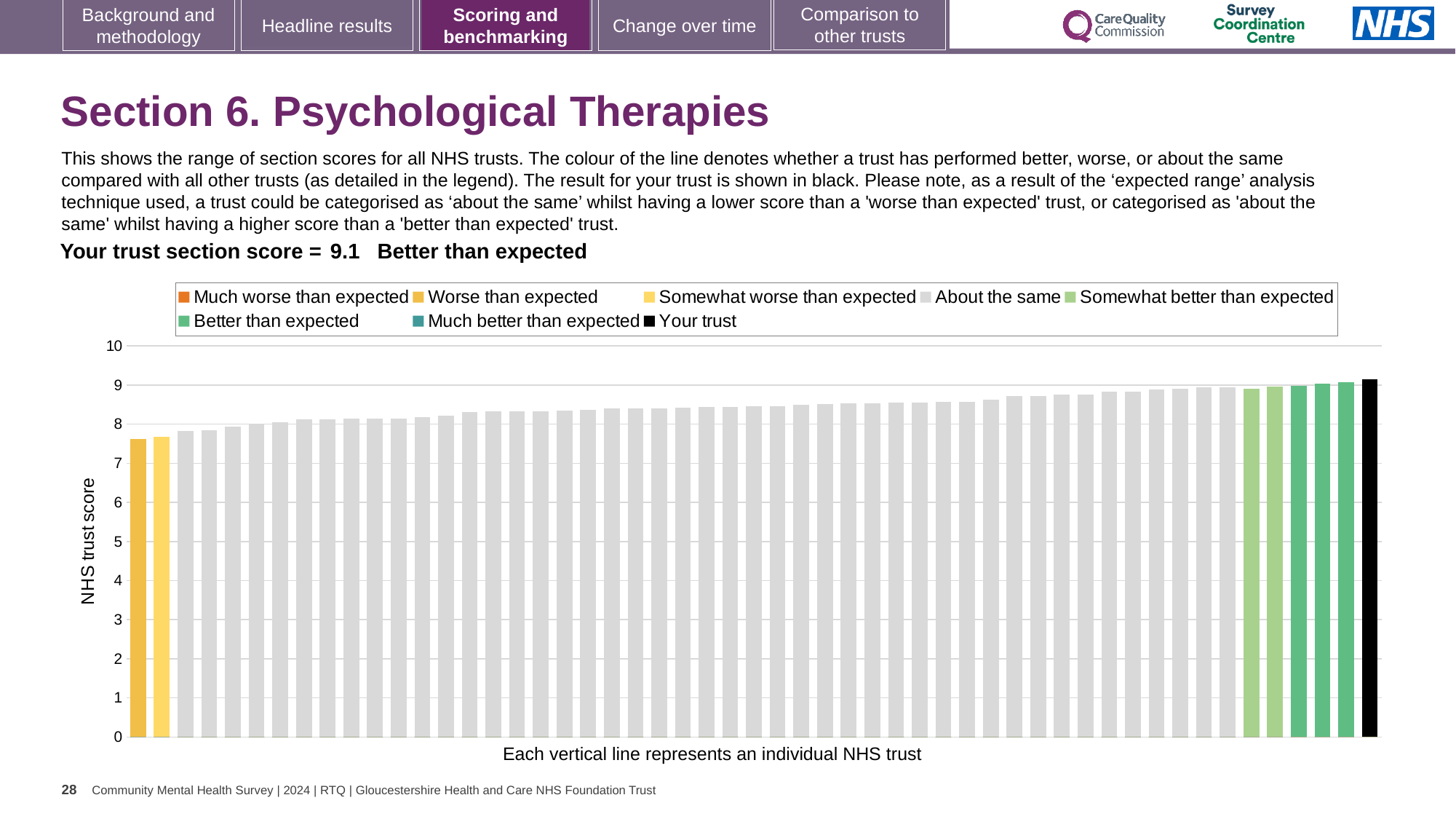
What is the label on the y axis of the chart? NHS trust score Is the value for your trust (the black bar) greater or less than 9? greater What kind of chart is shown on the slide? bar chart How many entries does the chart legend list? 8 Is the value of the leftmost bar greater or less than 8? less Is the value of the leftmost bar greater or less than 7? greater What does the x-axis caption say each vertical line represents? an individual NHS trust Which performance category is your trust's section score given as? Better than expected Do the bar values rise or fall from left to right along the x axis? rise What is the section score for your trust shown on the slide? 9.1 How many bars are coloured black on the chart? 1